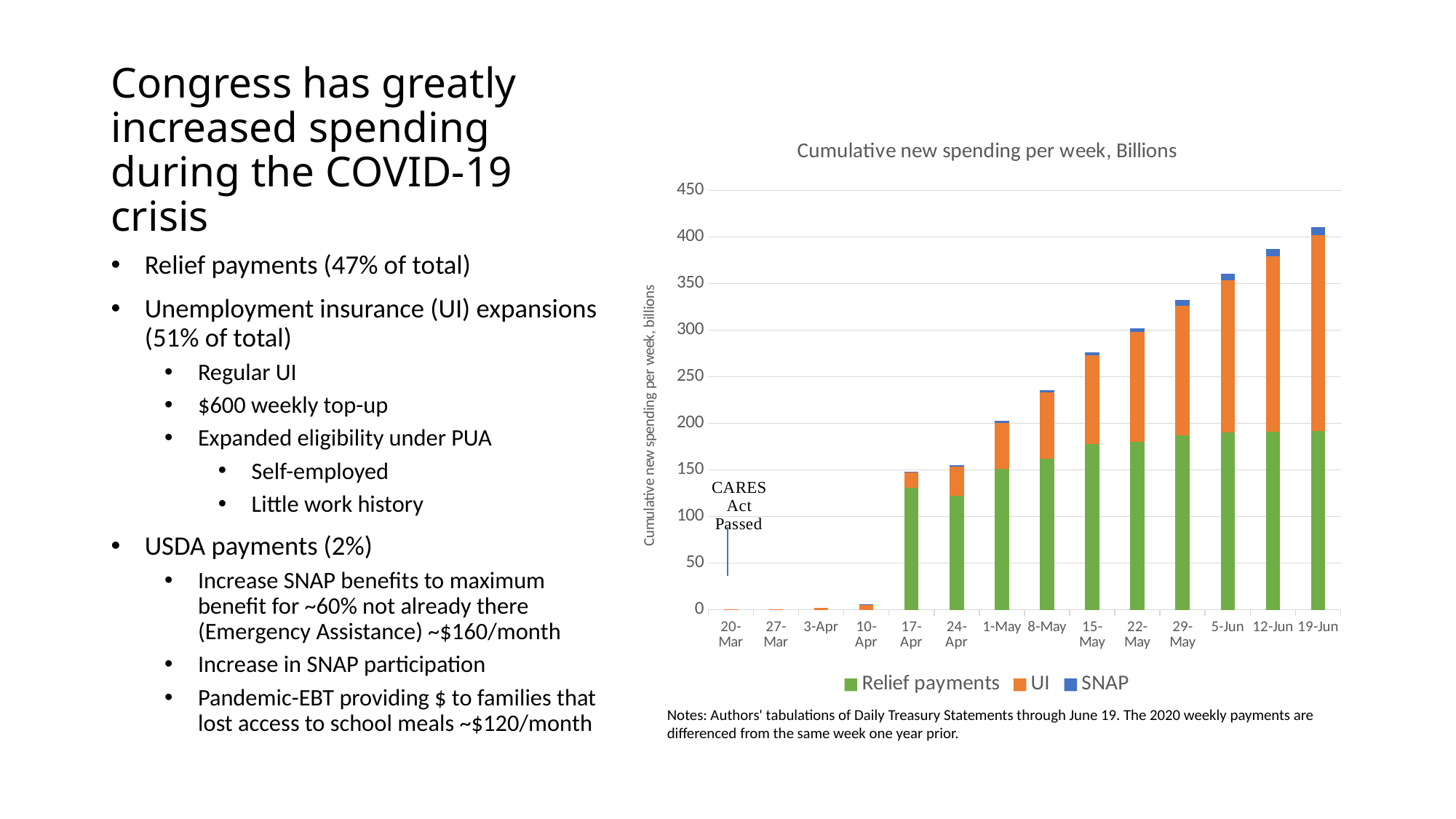
Which week has the highest total cumulative new spending? 19-Jun How many weeks (categories) are shown on the x axis of the chart? 14 How many series does the chart's legend list? 3 Is the total value for 12-Jun greater or less than 400? less Which has a larger total cumulative new spending, 17-Apr or 19-Jun? 19-Jun What event is annotated near the 20-Mar bar on the chart? CARES Act Passed Is the total value for 19-Jun greater or less than 400? greater What kind of chart is shown on the slide? Stacked bar chart Do the total bar heights rise or fall from 20-Mar to 19-Jun? Rise Is the total value for 5-Jun greater or less than 350? greater What is the title of the chart? Cumulative new spending per week, Billions